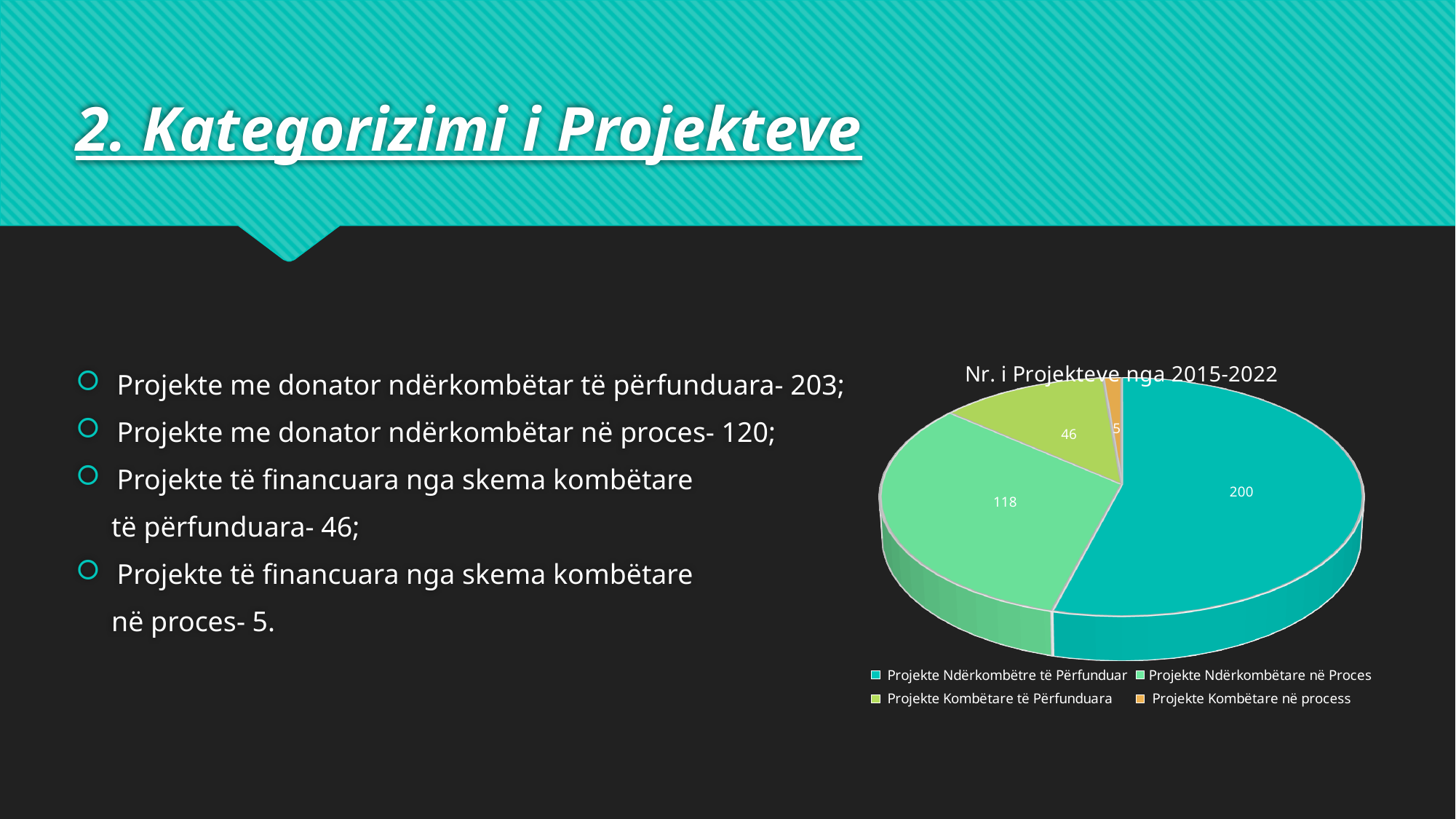
How many categories does the pie chart show? 4 What is the difference between the values for Projekte Ndërkombëtre të Përfunduar and Projekte Ndërkombëtare në Proces? 82 Which category has the largest slice in the pie chart? Projekte Ndërkombëtre të Përfunduar Which is larger in the pie chart: Projekte Ndërkombëtare në Proces or Projekte Kombëtare të Përfunduara? Projekte Ndërkombëtare në Proces What is the value for Projekte Ndërkombëtre të Përfunduar in the pie chart? 200 Which category has the smallest slice in the pie chart? Projekte Kombëtare në process What is the value for Projekte Ndërkombëtare në Proces in the pie chart? 118 What is the value for Projekte Kombëtare të Përfunduara in the pie chart? 46 What is the difference between the values for Projekte Kombëtare të Përfunduara and Projekte Kombëtare në process? 41 What is the value for Projekte Kombëtare në process in the pie chart? 5 What is the title of the chart on the slide? Nr. i Projekteve nga 2015-2022 What type of chart is shown on the slide? Pie chart